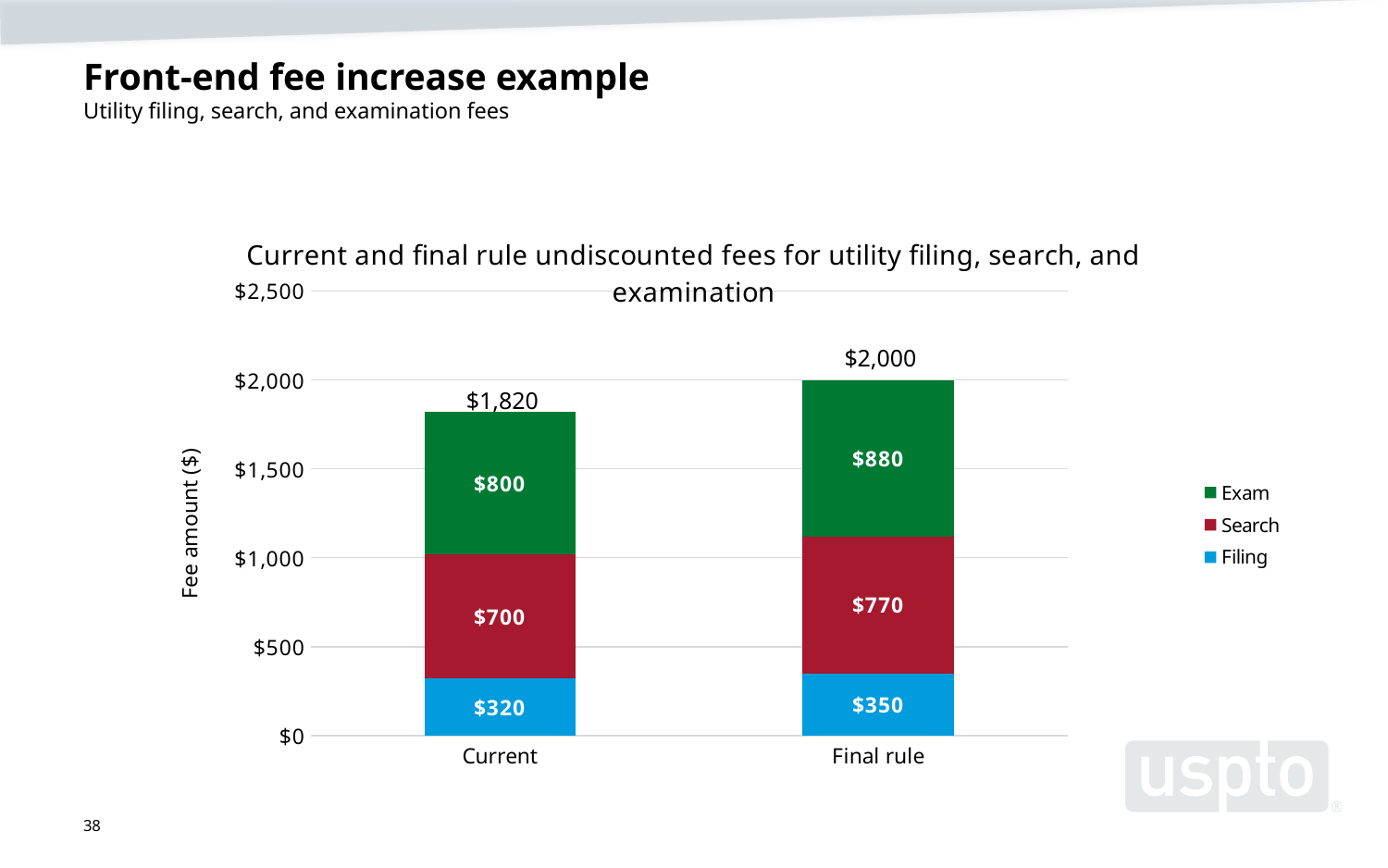
What is the total fee for the Current bar? $1,820 Which fee component is the largest in the Current bar? Exam What is the difference between the Final rule total and the Current total? $180 What is the total fee for the Final rule bar? $2,000 What is the Search fee under Current? $700 What kind of chart is shown? Stacked bar chart How much higher is the Final rule Exam fee than the Current Exam fee? $80 Which colour represents Filing in the chart? Blue What is the Filing fee for the Final rule? $350 What is the Exam fee for the Final rule? $880 Which category has the higher Search fee, Current or Final rule? Final rule How many series does the legend list? 3